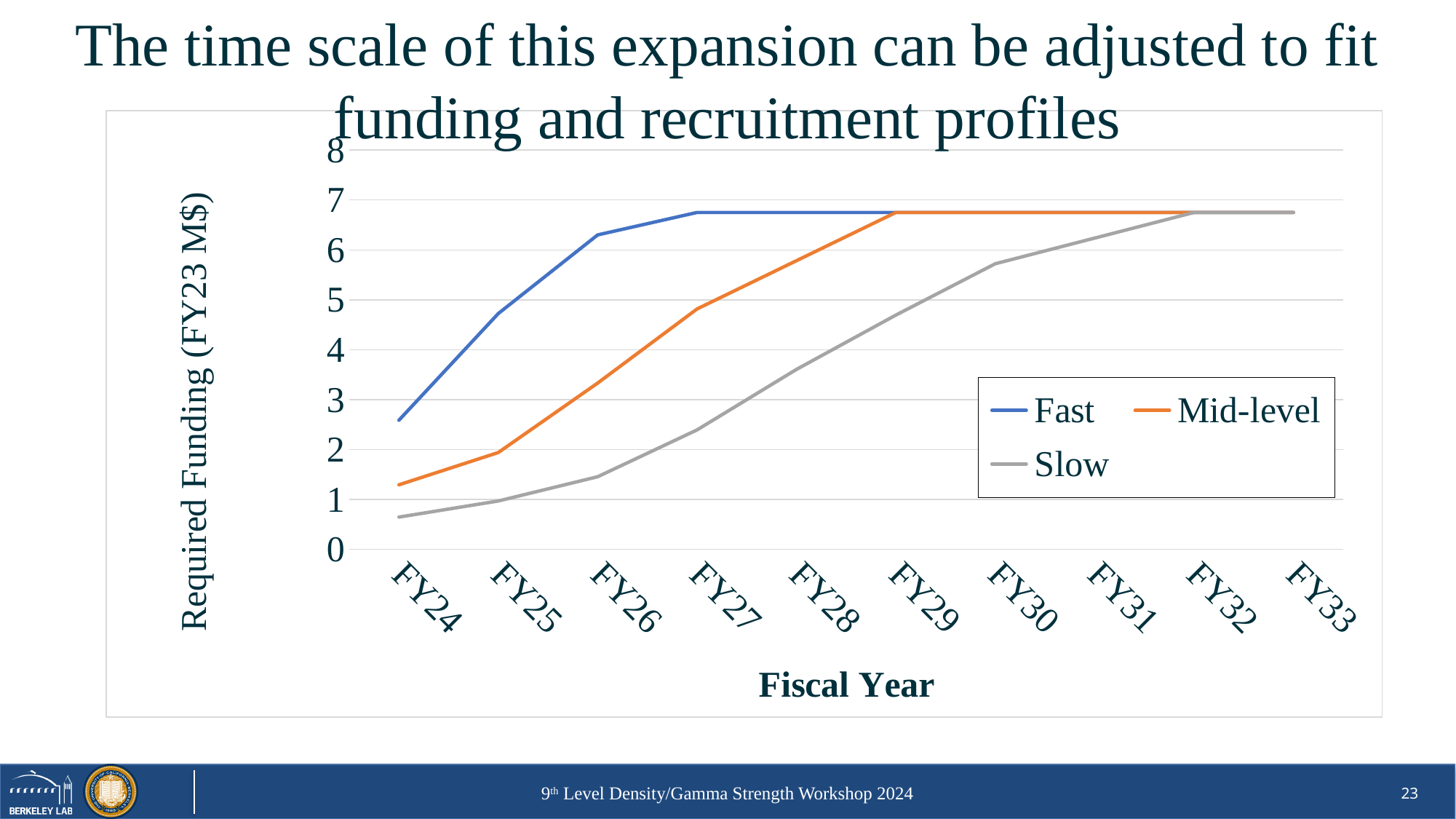
In FY26, which series has the larger value, Fast or Slow? Fast How many series does the legend list? 3 Is the value for Fast in FY24 greater or less than 2? greater What is the title of the y axis? Required Funding (FY23 M$) What kind of chart is shown on the slide? line chart How many fiscal years are shown on the x axis? 10 What is the title of the x axis? Fiscal Year Is the value for Fast in FY26 greater or less than 6? greater Is the value for Mid-level in FY27 greater or less than 4? greater In FY25, which series has the larger value, Mid-level or Slow? Mid-level Does the Slow series rise or fall from FY24 to FY33? rise